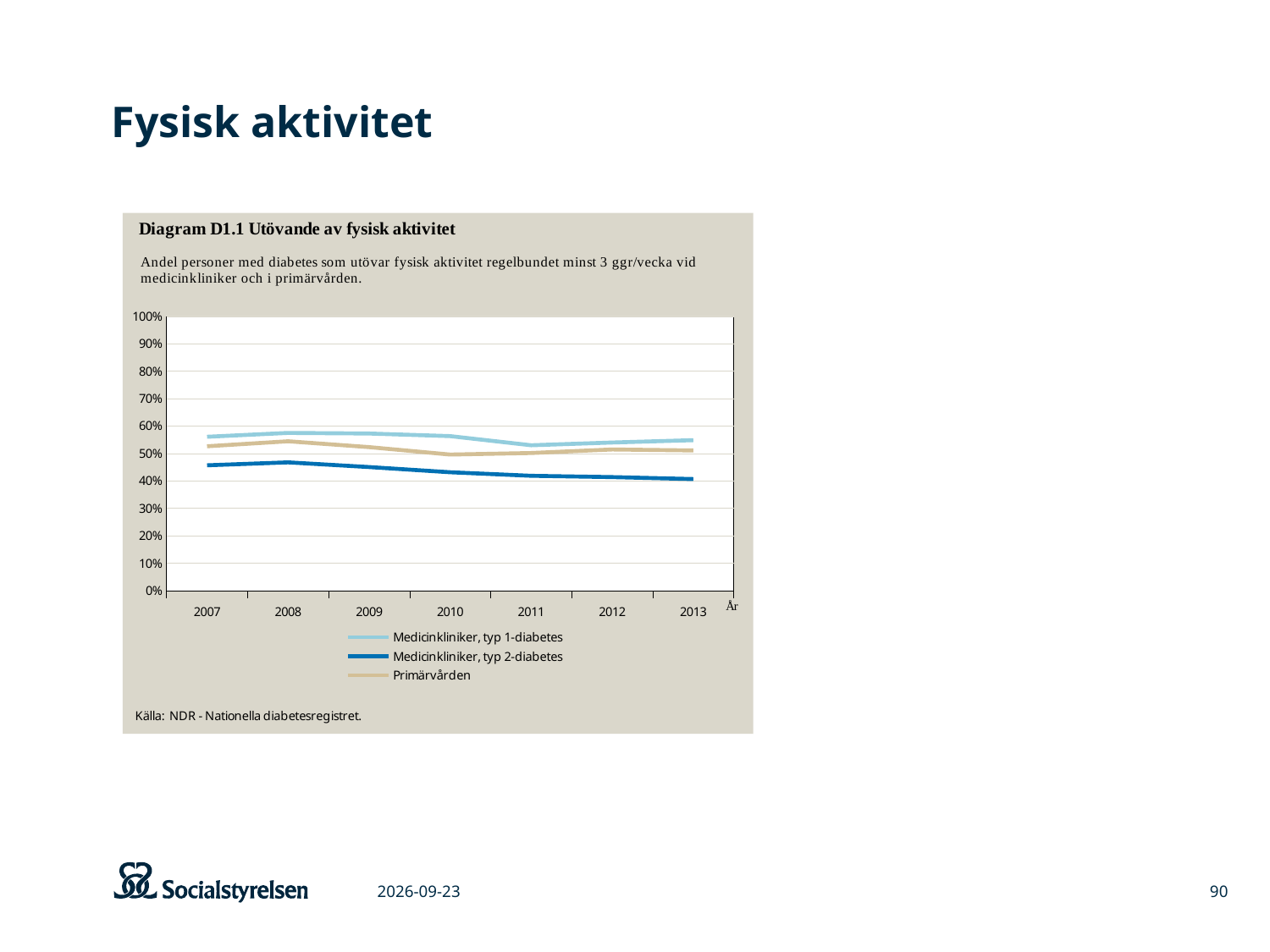
What is the title of the diagram on the slide? Diagram D1.1 Utövande av fysisk aktivitet Is the value for Medicinkliniker, typ 2-diabetes in 2013 greater or less than 50%? less Does the value for Medicinkliniker, typ 2-diabetes rise or fall from 2008 to 2013? fall Is the value for Medicinkliniker, typ 1-diabetes in 2008 greater or less than 50%? greater How many years are shown on the x axis of the chart? 7 How many series does the legend of the chart list? 3 What is the first year shown on the x axis of the chart? 2007 What kind of chart is shown in Diagram D1.1? line chart In 2007, which is larger: the value for Primärvården or the value for Medicinkliniker, typ 2-diabetes? Primärvården Is the value for Primärvården in 2010 greater or less than 60%? less Which series has the highest value in 2013? Medicinkliniker, typ 1-diabetes Which series has the lowest value in 2007? Medicinkliniker, typ 2-diabetes